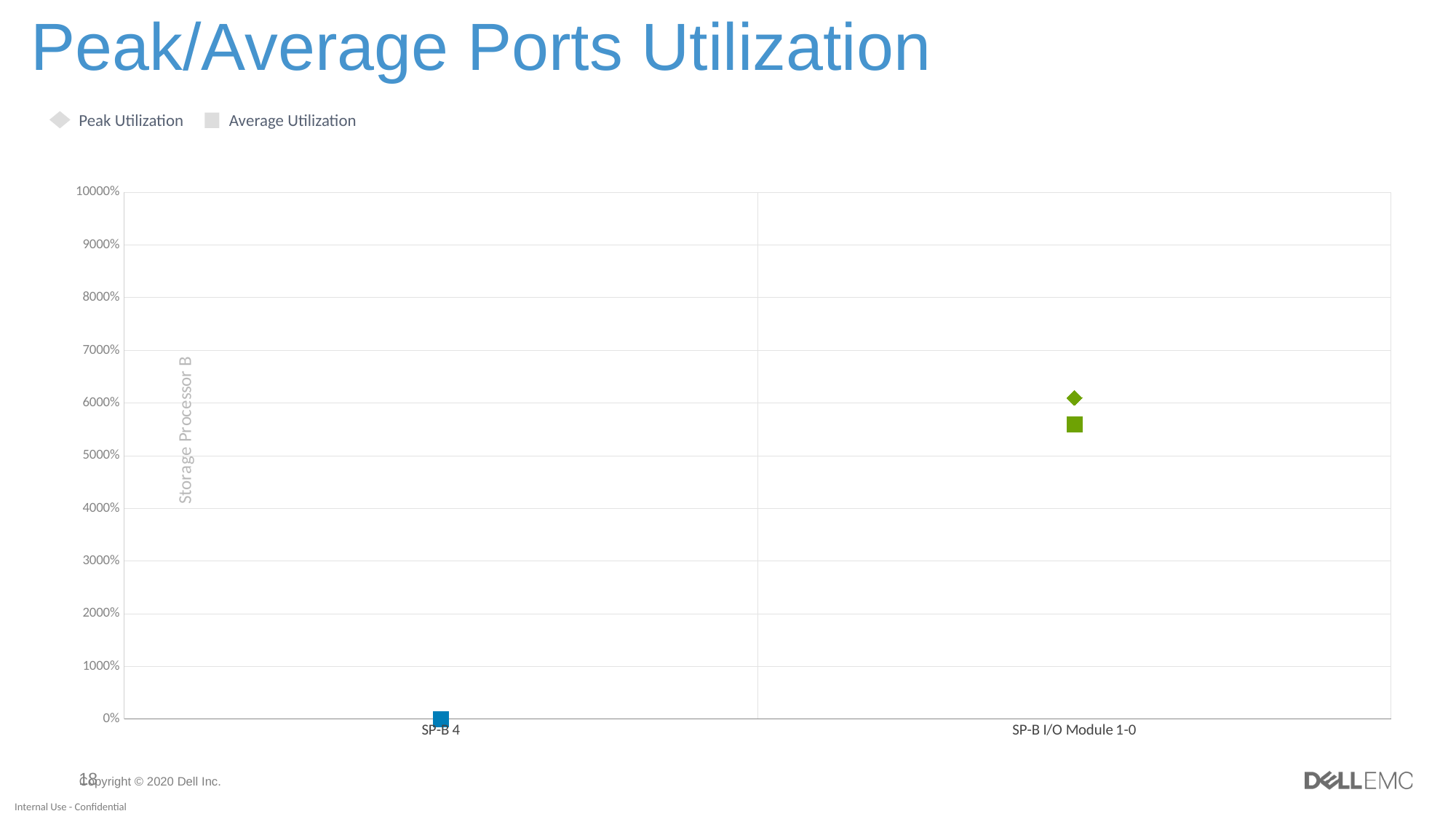
How many categories are shown on the x axis? 2 For SP-B I/O Module 1-0, which is larger: Peak Utilization or Average Utilization? Peak Utilization Is the Peak Utilization value for SP-B I/O Module 1-0 greater or less than 5000%? greater Is the Average Utilization value for SP-B I/O Module 1-0 greater or less than 6000%? less What is the title of the chart? Peak/Average Ports Utilization Which category has the lowest Average Utilization? SP-B 4 Is the Peak Utilization value for SP-B I/O Module 1-0 greater or less than 7000%? less Which category has the higher Average Utilization, SP-B 4 or SP-B I/O Module 1-0? SP-B I/O Module 1-0 What are the two series named in the legend? Peak Utilization and Average Utilization What is the Average Utilization value for SP-B 4? 0% How many series does the legend list? 2